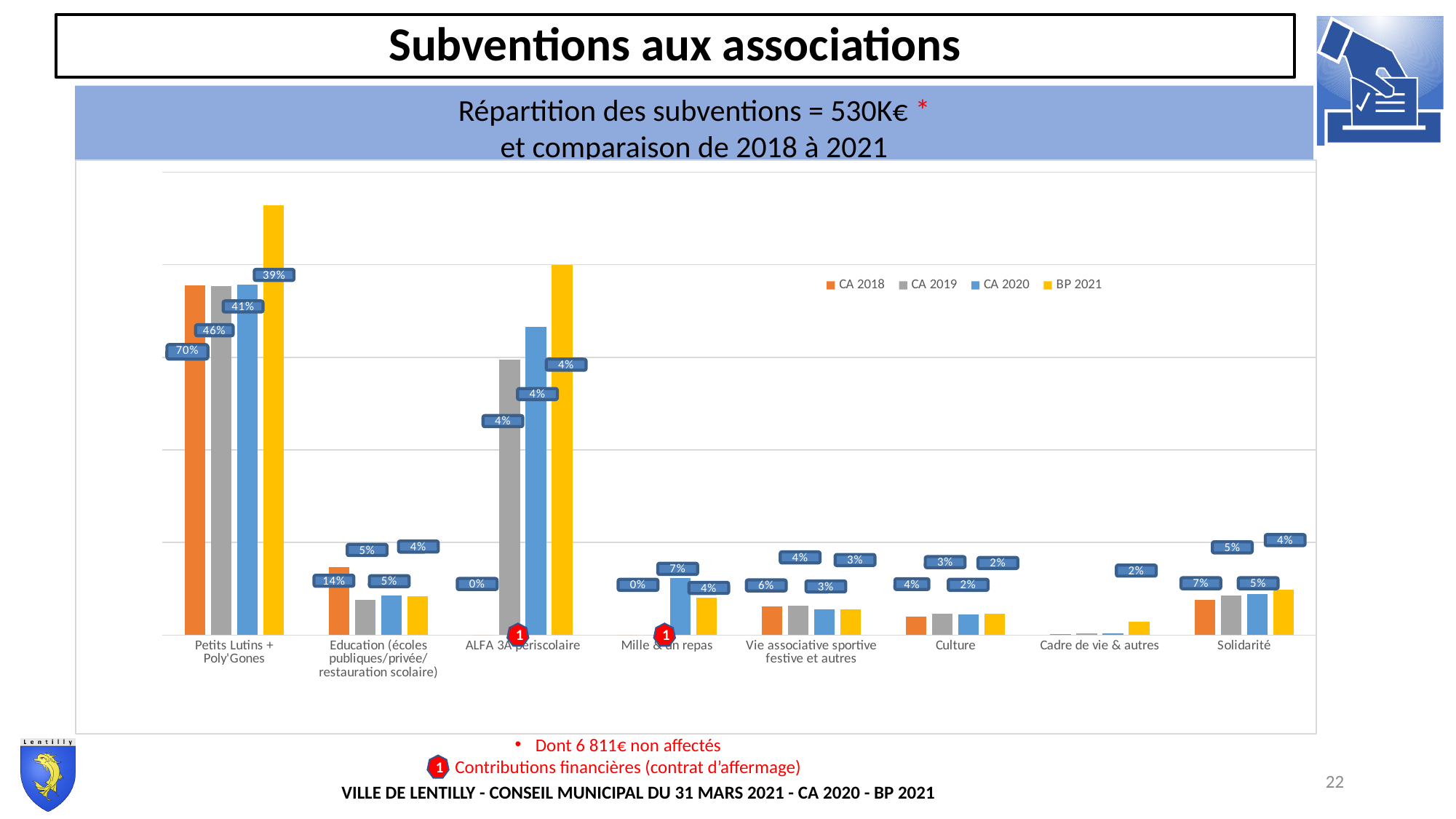
What is the difference between the CA 2018 value for Petits Lutins + Poly'Gones and the CA 2018 value for Education (écoles publiques/privée/restauration scolaire)? 56 percentage points What kind of chart is shown on the slide? Bar chart What is the BP 2021 value for Cadre de vie & autres? 2% What is the CA 2018 value for Education (écoles publiques/privée/restauration scolaire)? 14% What is the CA 2018 value for Petits Lutins + Poly'Gones? 70% Which is larger: the CA 2018 value for Vie associative sportive festive et autres or the CA 2018 value for Culture? Vie associative sportive festive et autres What is the CA 2018 value for Solidarité? 7% How many series does the chart legend list? 4 How many categories are shown along the x axis of the chart? 8 Which series is shown in yellow in the chart legend? BP 2021 Which category has the highest CA 2018 value? Petits Lutins + Poly'Gones What is the BP 2021 value for Petits Lutins + Poly'Gones? 39%